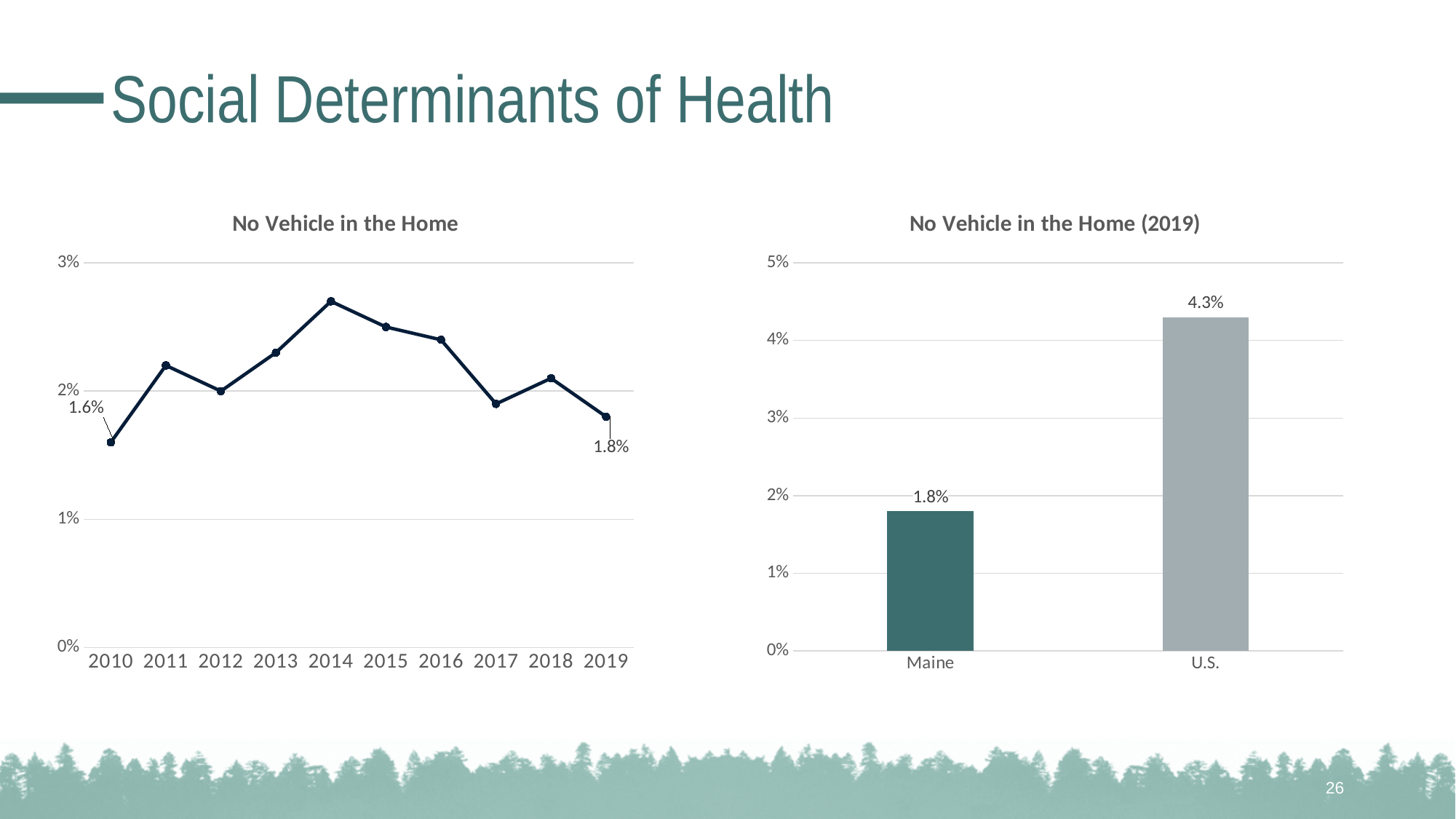
In the 'No Vehicle in the Home (2019)' chart, what kind of chart is shown? bar chart In the 'No Vehicle in the Home' line chart, what kind of chart is shown? line chart In the 'No Vehicle in the Home (2019)' chart, what is the value for the U.S.? 4.3% In the 'No Vehicle in the Home (2019)' chart, what is the value for Maine? 1.8% In the 'No Vehicle in the Home' line chart, is the value for 2014 larger or smaller than the value for 2017? larger In the 'No Vehicle in the Home' line chart, what is the value for 2019? 1.8% In the 'No Vehicle in the Home' line chart, which year has the lowest value? 2010 In the 'No Vehicle in the Home' line chart, how many years are plotted? 10 In the 'No Vehicle in the Home (2019)' chart, what is the difference between the U.S. and Maine values? 2.5% In the 'No Vehicle in the Home' line chart, is the value for 2014 greater or less than 2%? greater In the 'No Vehicle in the Home' line chart, what is the value for 2010? 1.6% In the 'No Vehicle in the Home' line chart, which year has the highest value? 2014